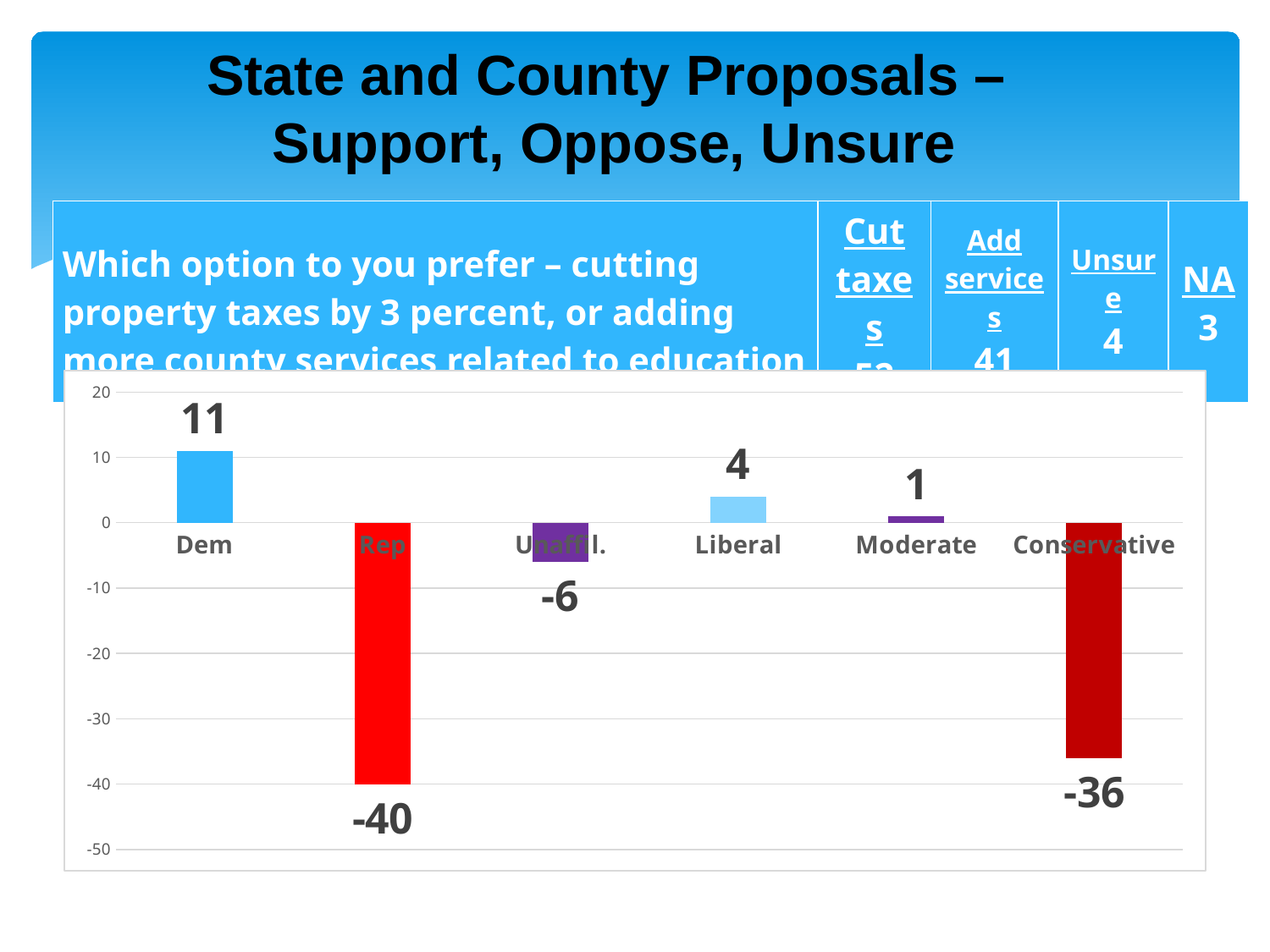
What is the value for Dem? 11 What is the value for Moderate? 1 Which category has the lowest value? Rep How many categories are shown on the x axis? 6 Which is larger, the value for Liberal or the value for Moderate? Liberal Which category has the highest value? Dem What is the value for Conservative? -36 Is the value for Conservative greater or less than -30? less What is the difference between the values for Dem and Liberal? 7 What is the value for Unaffil.? -6 What is the value for Rep? -40 What kind of chart is shown on the slide? bar chart